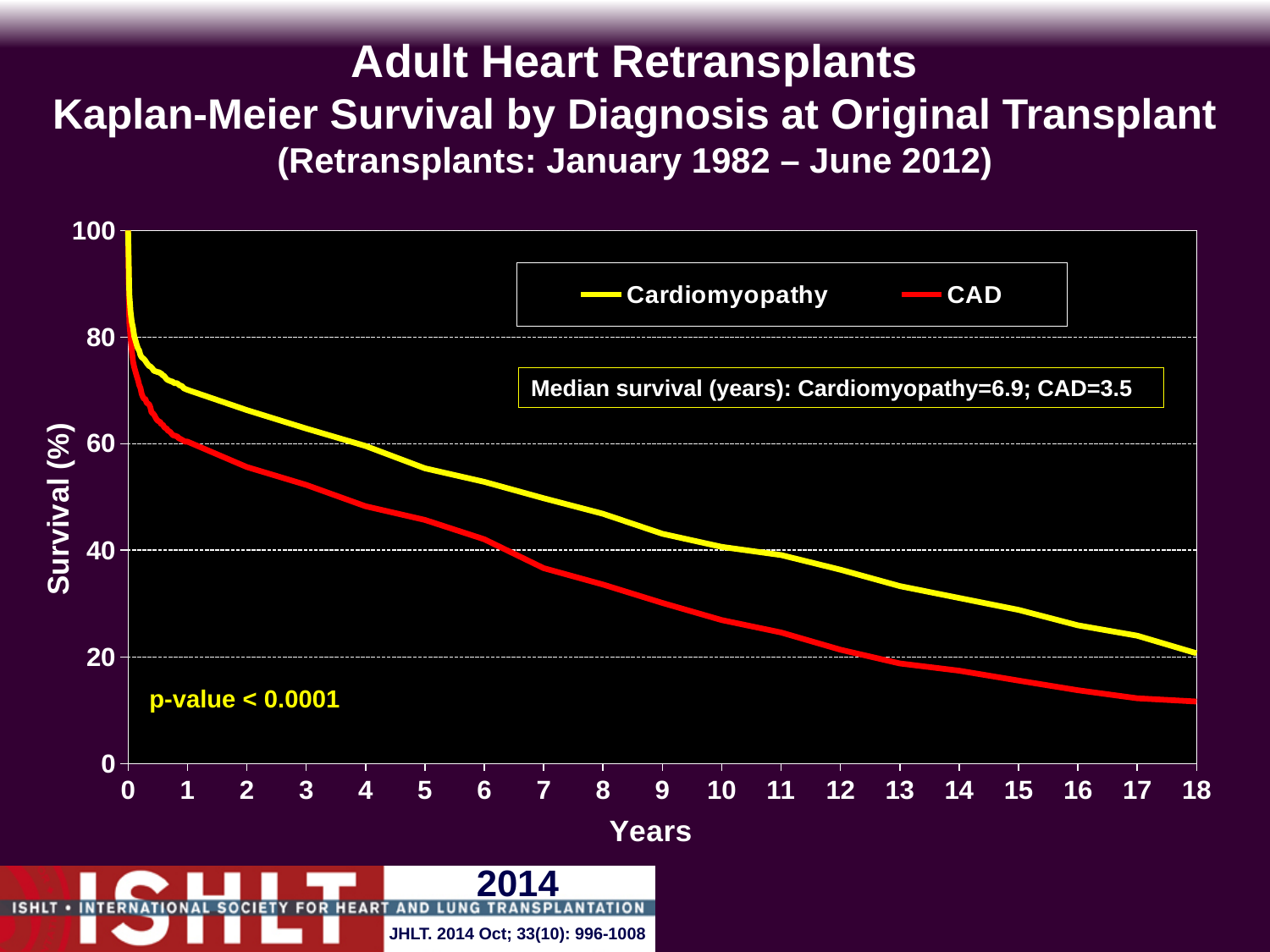
Is the survival value for Cardiomyopathy at 5 years greater or less than 40? greater What p-value is shown on the chart? p-value < 0.0001 Do the survival curves rise or fall as years increase? fall How many series does the legend list? 2 What kind of chart is shown on the slide? line chart What is the median survival in years for CAD? 3.5 What is the median survival in years for Cardiomyopathy? 6.9 Is the survival value for CAD at 10 years greater or less than 40? less Is the survival value for CAD at 18 years greater or less than 20? less Which diagnosis group has the higher median survival, Cardiomyopathy or CAD? Cardiomyopathy Which series has the higher survival at 10 years, Cardiomyopathy or CAD? Cardiomyopathy By how many years does the median survival for Cardiomyopathy exceed that for CAD? 3.4